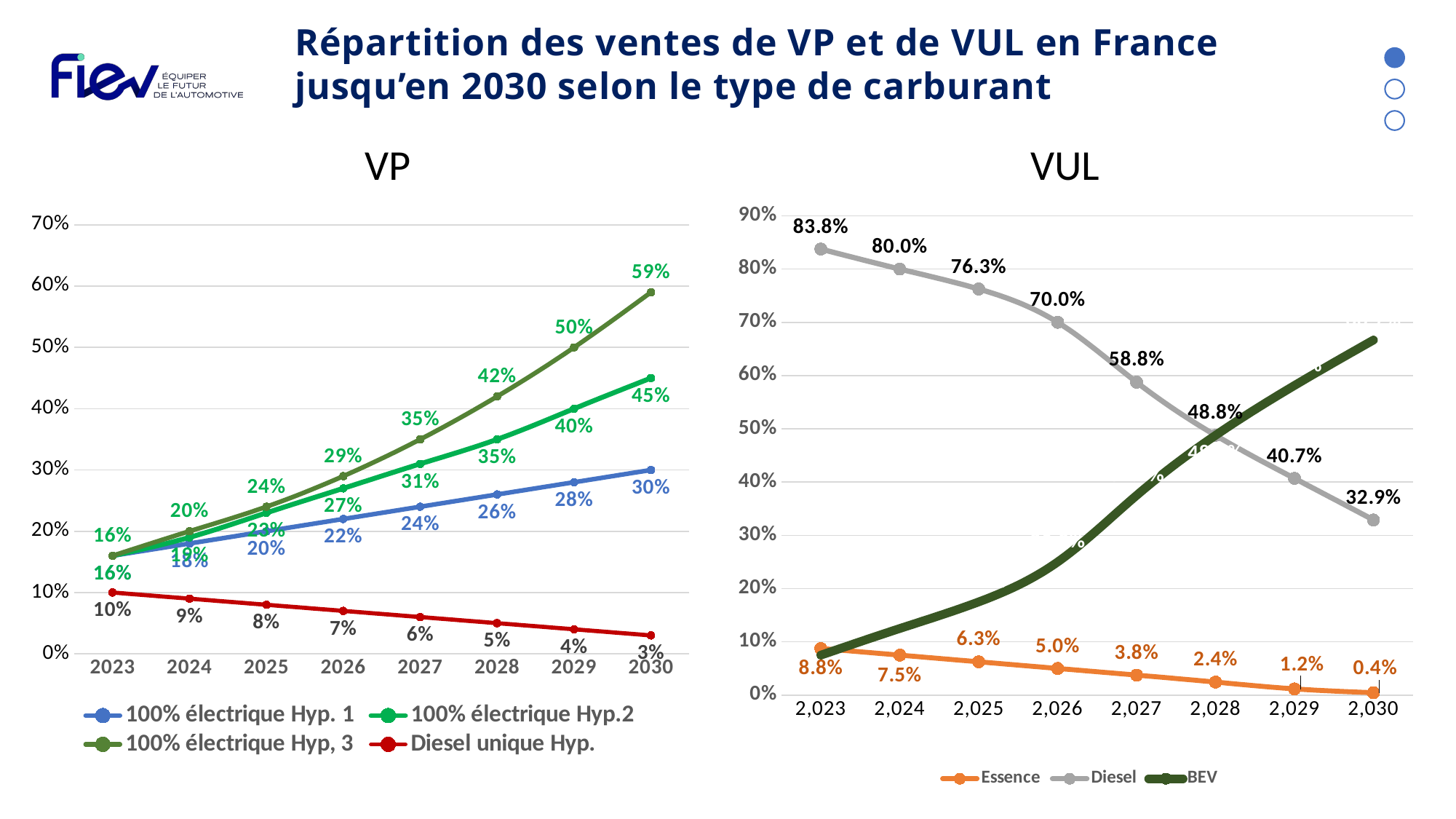
In the VP chart, how many series does the legend list? 4 In the VP chart, what is the difference between 100% électrique Hyp, 3 and 100% électrique Hyp.2 in 2030? 14% In the VP chart, what is the value for 100% électrique Hyp. 1 in 2027? 24% In the VP chart, does the Diesel unique Hyp. series rise or fall from 2023 to 2030? fall What type of chart is the VUL chart? line chart In the VP chart, what is the value for 100% électrique Hyp, 3 in 2030? 59% In the VUL chart, what is the value for Essence in 2030? 0.4% In the VP chart, what is the value for Diesel unique Hyp. in 2023? 10% In the VUL chart, what is the difference between the Diesel values in 2023 and 2030? 50.9% In the VUL chart, what is the value for Diesel in 2026? 70.0% In the VUL chart, in which year is the Diesel value lowest? 2,030 In the VUL chart, is the BEV value in 2030 greater or less than 60%? greater